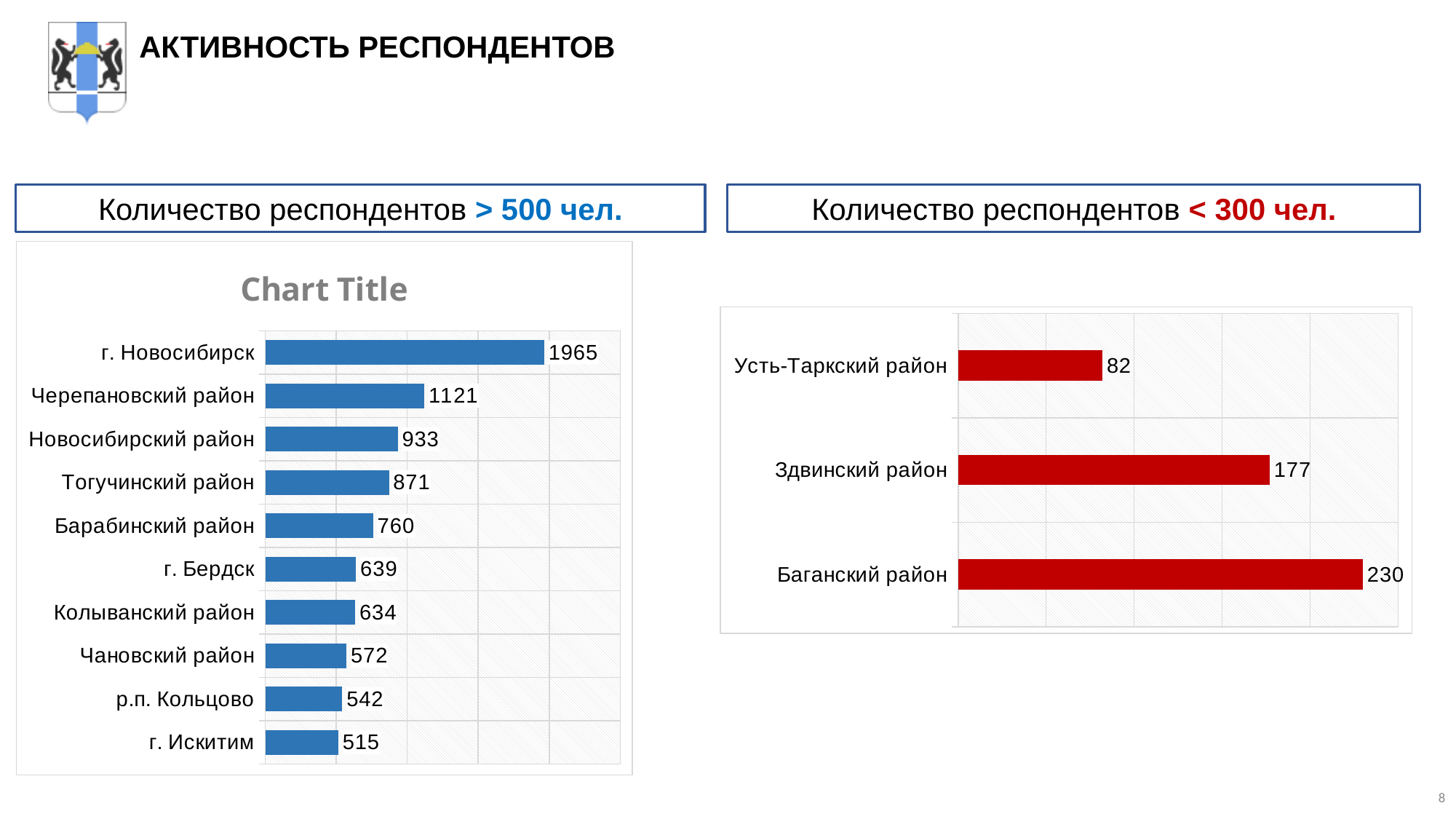
In the left chart (Количество респондентов > 500 чел.), which category has the lowest value? г. Искитим In the left chart (Количество респондентов > 500 чел.), what is the value for Барабинский район? 760 In the right chart (Количество респондентов < 300 чел.), what is the value for Здвинский район? 177 What type of chart is the left chart (Количество респондентов > 500 чел.)? bar chart What title is displayed above the left chart (Количество респондентов > 500 чел.)? Chart Title In the left chart (Количество респондентов > 500 чел.), what is the value for г. Новосибирск? 1965 In the right chart (Количество респондентов < 300 чел.), what is the difference between Баганский район and Усть-Таркский район? 148 In the right chart (Количество респондентов < 300 чел.), which category has the highest value? Баганский район How many categories are shown in the left chart (Количество респондентов > 500 чел.)? 10 In the left chart (Количество респондентов > 500 чел.), which is larger: Тогучинский район or Новосибирский район? Новосибирский район How many categories are shown in the right chart (Количество респондентов < 300 чел.)? 3 In the left chart (Количество респондентов > 500 чел.), what is the difference between г. Новосибирск and Черепановский район? 844